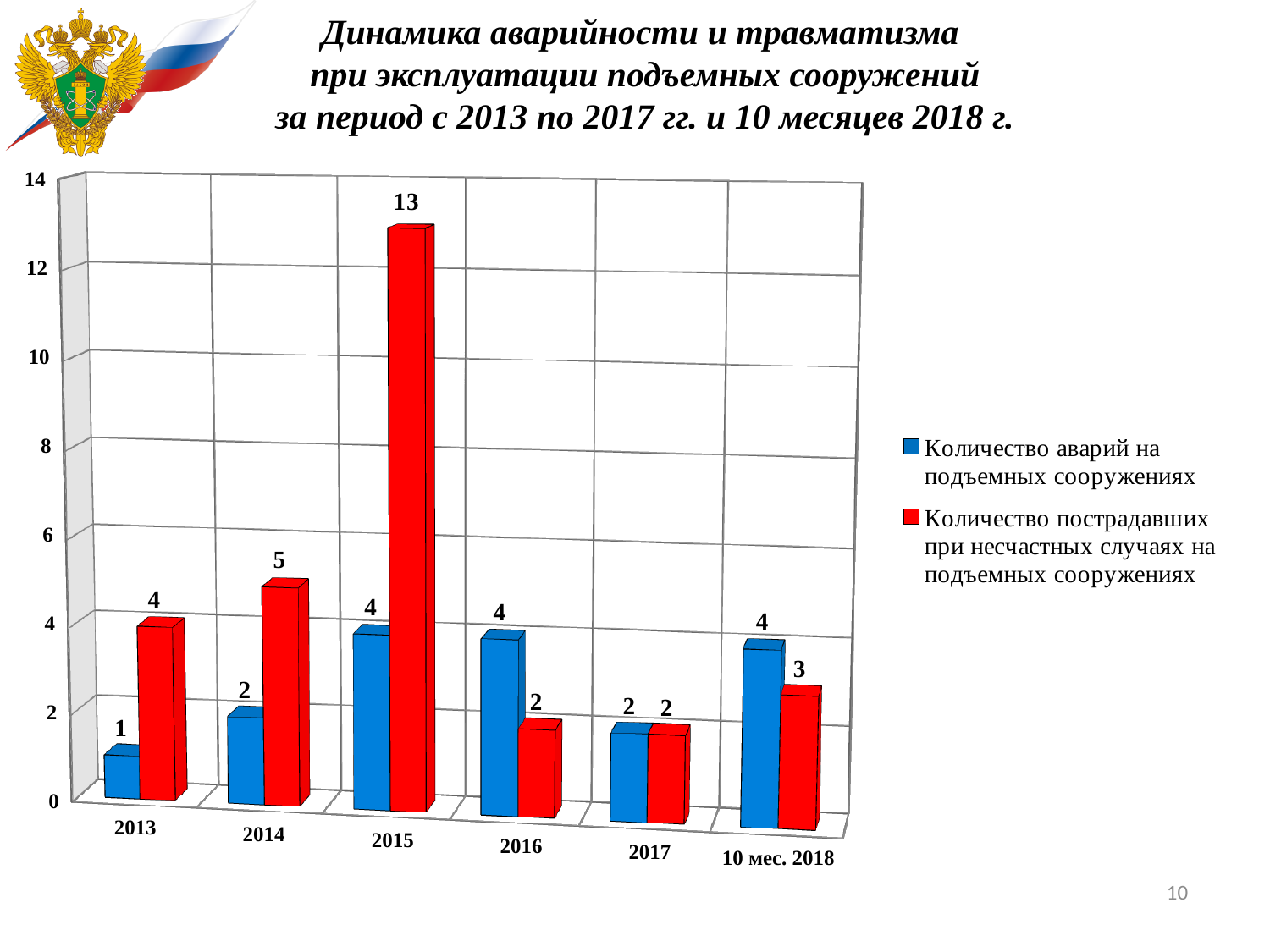
What is the total of accidents and injured persons in 2014? 7 Which is larger in 2016: the number of accidents or the number of injured persons? the number of accidents What kind of chart is shown on the slide? bar chart In which year is the number of injured persons (red series) highest? 2015 How many series does the legend list? 2 In which year is the number of accidents (blue series) lowest? 2013 What is the difference between the number of injured persons and the number of accidents in 2015? 9 Which colour represents the number of injured persons (Количество пострадавших) in the legend? red How many injured persons (Количество пострадавших при несчастных случаях на подъемных сооружениях) were recorded in 2015? 13 How many categories (periods) are shown on the x axis? 6 How many accidents on lifting structures (Количество аварий на подъемных сооружениях) were recorded in 2013? 1 What is the value for accidents (blue series) for 10 мес. 2018? 4